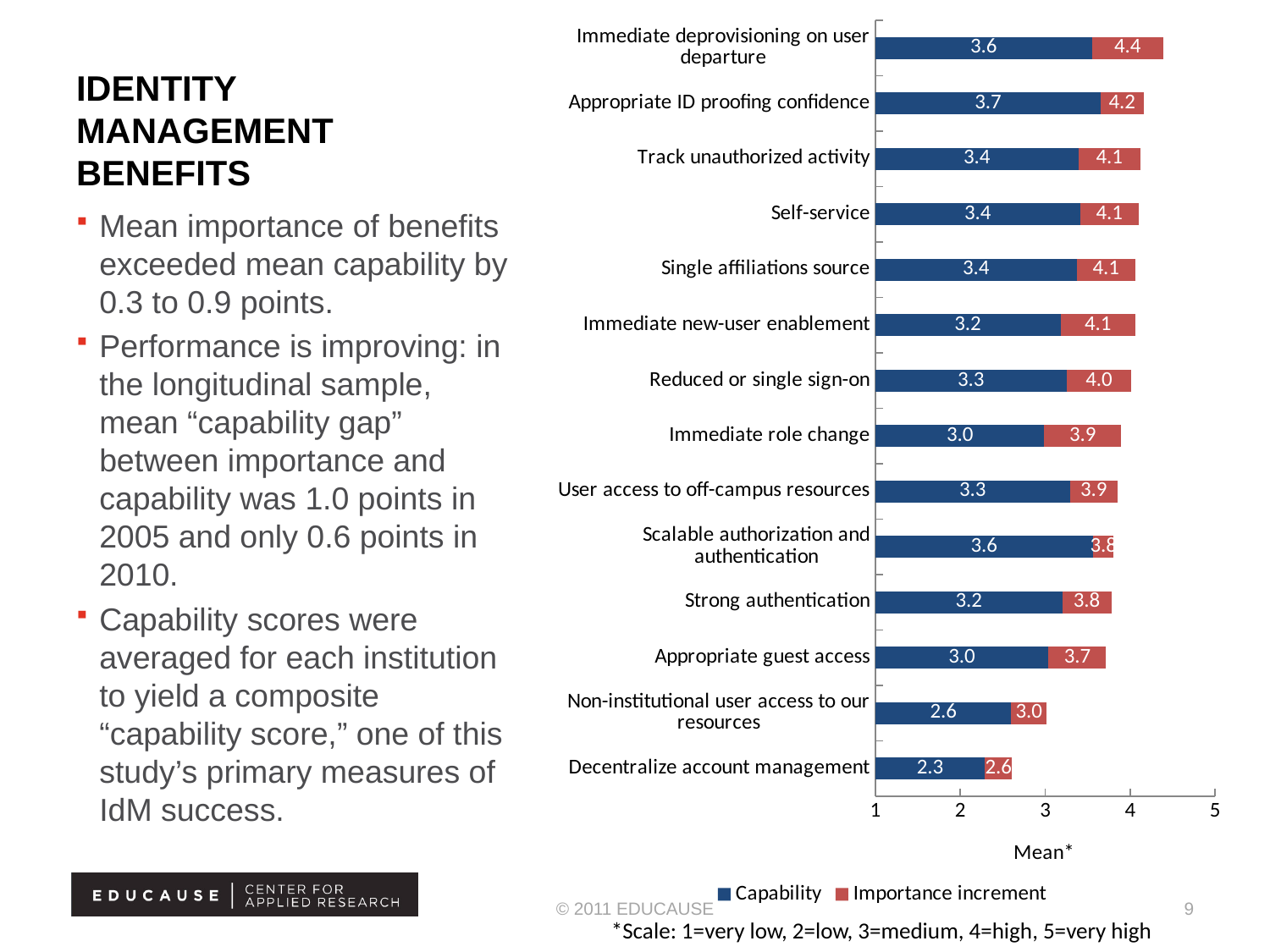
What value is printed at the end of the Importance increment segment for Immediate deprovisioning on user departure? 4.4 How many categories are shown in the chart? 14 For Immediate deprovisioning on user departure, what is the difference between the value printed on the red segment (4.4) and the Capability value (3.6)? 0.8 What is the title of the horizontal axis? Mean* Which category has the lowest Capability value? Decentralize account management Is the Capability value for Non-institutional user access to our resources greater or less than 3? less How many series does the legend list? 2 What is the Capability value for Appropriate ID proofing confidence? 3.7 What kind of chart is shown on the slide? Stacked horizontal bar chart Which category has the highest Capability value? Appropriate ID proofing confidence What is the Capability value for Decentralize account management? 2.3 Which has the larger Capability value: Immediate deprovisioning on user departure or Strong authentication? Immediate deprovisioning on user departure